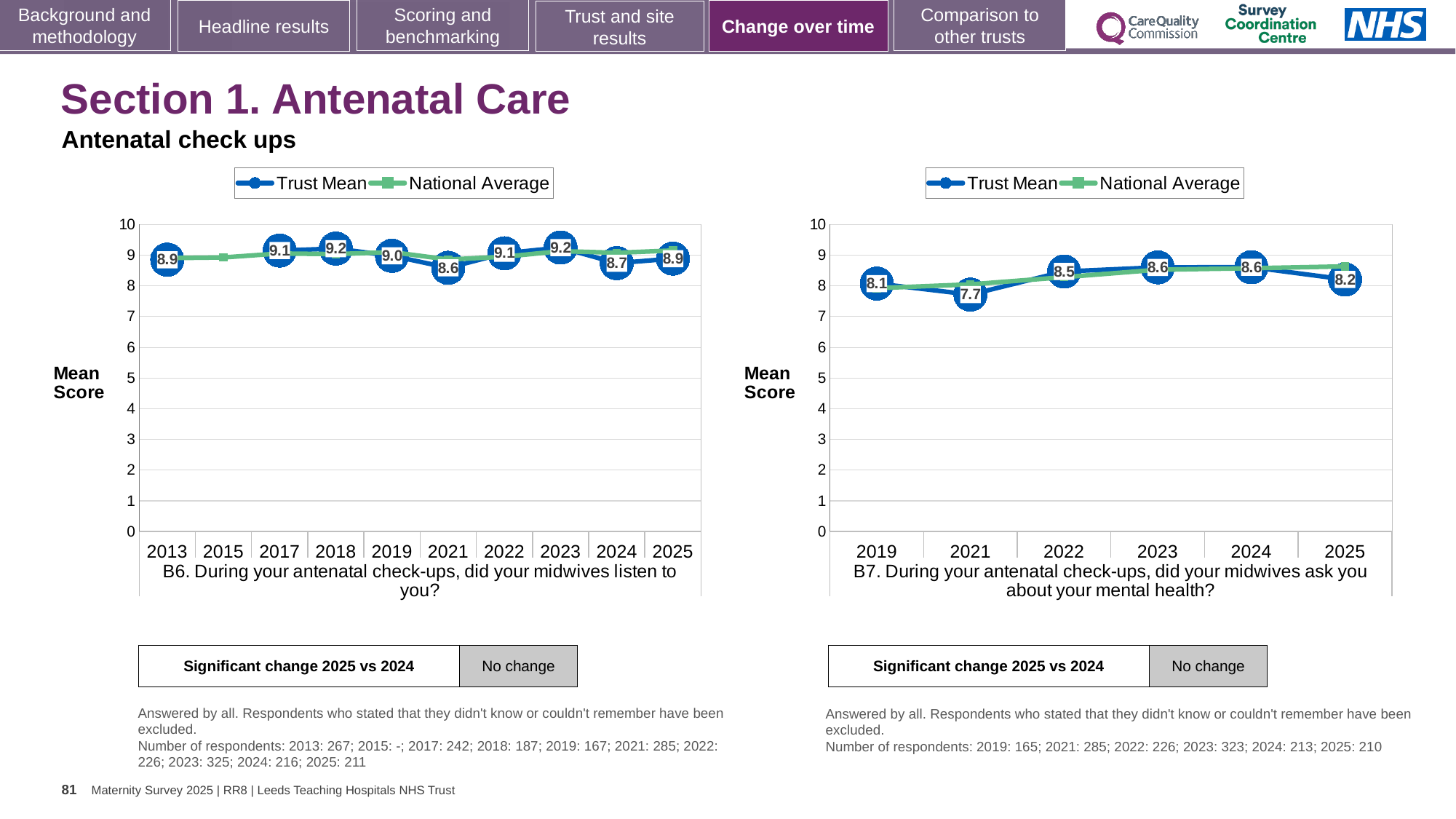
In the B7 chart on the right, what is the Trust Mean score for 2025? 8.2 How many years are shown on the x axis of the B7 chart on the right? 6 In the B7 chart on the right, does the Trust Mean score rise or fall from 2024 to 2025? Fall In the B7 chart on the right, what is the difference between the Trust Mean scores for 2024 and 2025? 0.4 In the B7 chart on the right, which year has the lowest Trust Mean score? 2021 In the B6 chart on the left, what is the Trust Mean score for 2025? 8.9 How many series does the legend of the B6 chart on the left list? 2 In the B6 chart on the left, which year has the lowest Trust Mean score? 2021 What kind of chart is the B7 chart on the right? Line chart In the B7 chart on the right, what is the Trust Mean score for 2021? 7.7 In the B6 chart on the left, what is the Trust Mean score for 2021? 8.6 In the B6 chart on the left, is the Trust Mean score for 2018 or 2024 higher? 2018